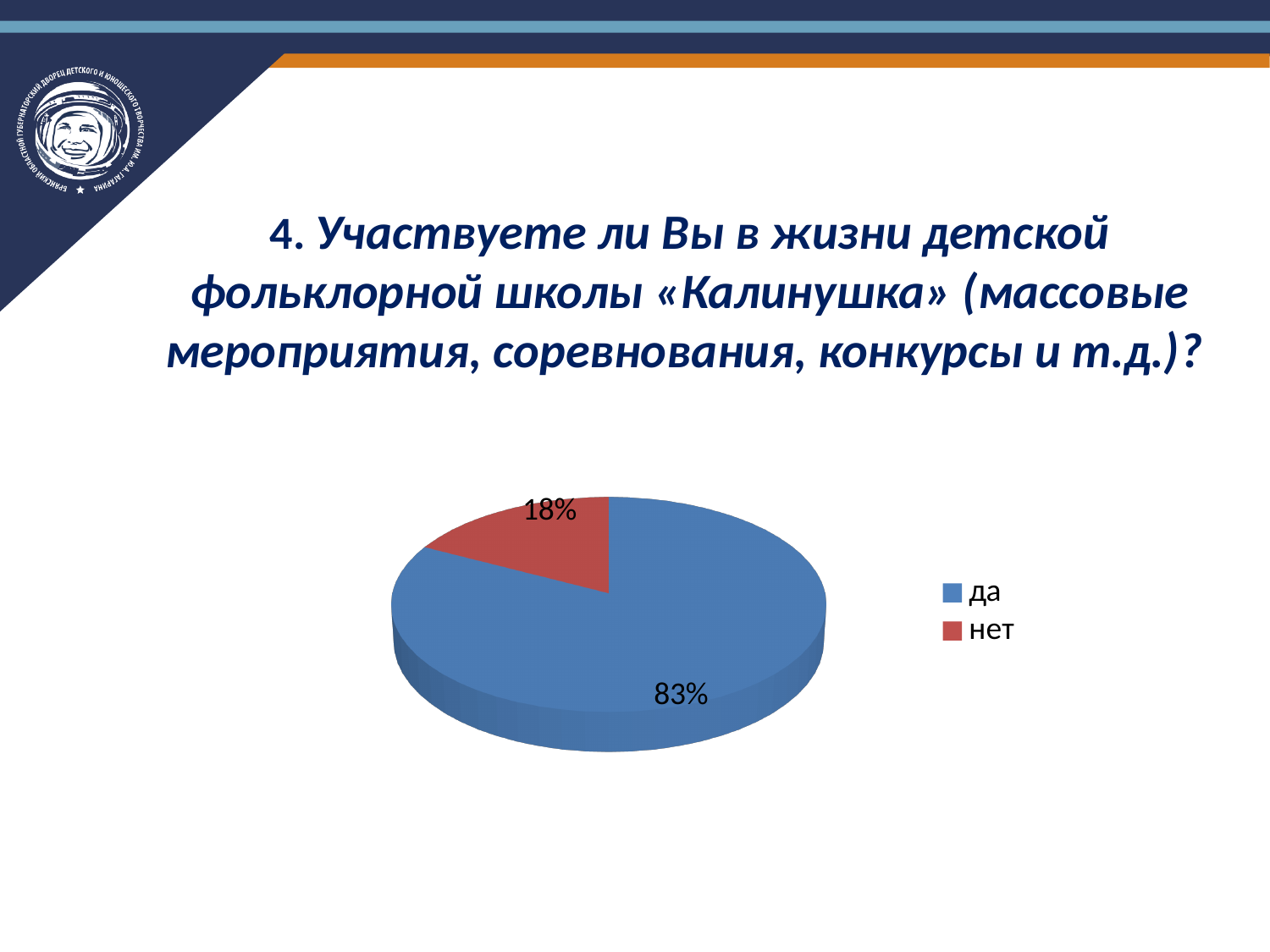
What colour is the slice for "нет"? Red What kind of chart is shown on the slide? Pie chart Which answer has the largest share of the pie? да What colour is the slice for "да"? Blue Which is larger, the share for "да" or the share for "нет"? да How many slices does the pie chart have? 2 What percentage of respondents answered "нет"? 18% What is the difference in percentage points between the "да" and "нет" shares? 65 What percentage of respondents answered "да"? 83% How many entries does the legend list? 2 Which answer has the smallest share of the pie? нет